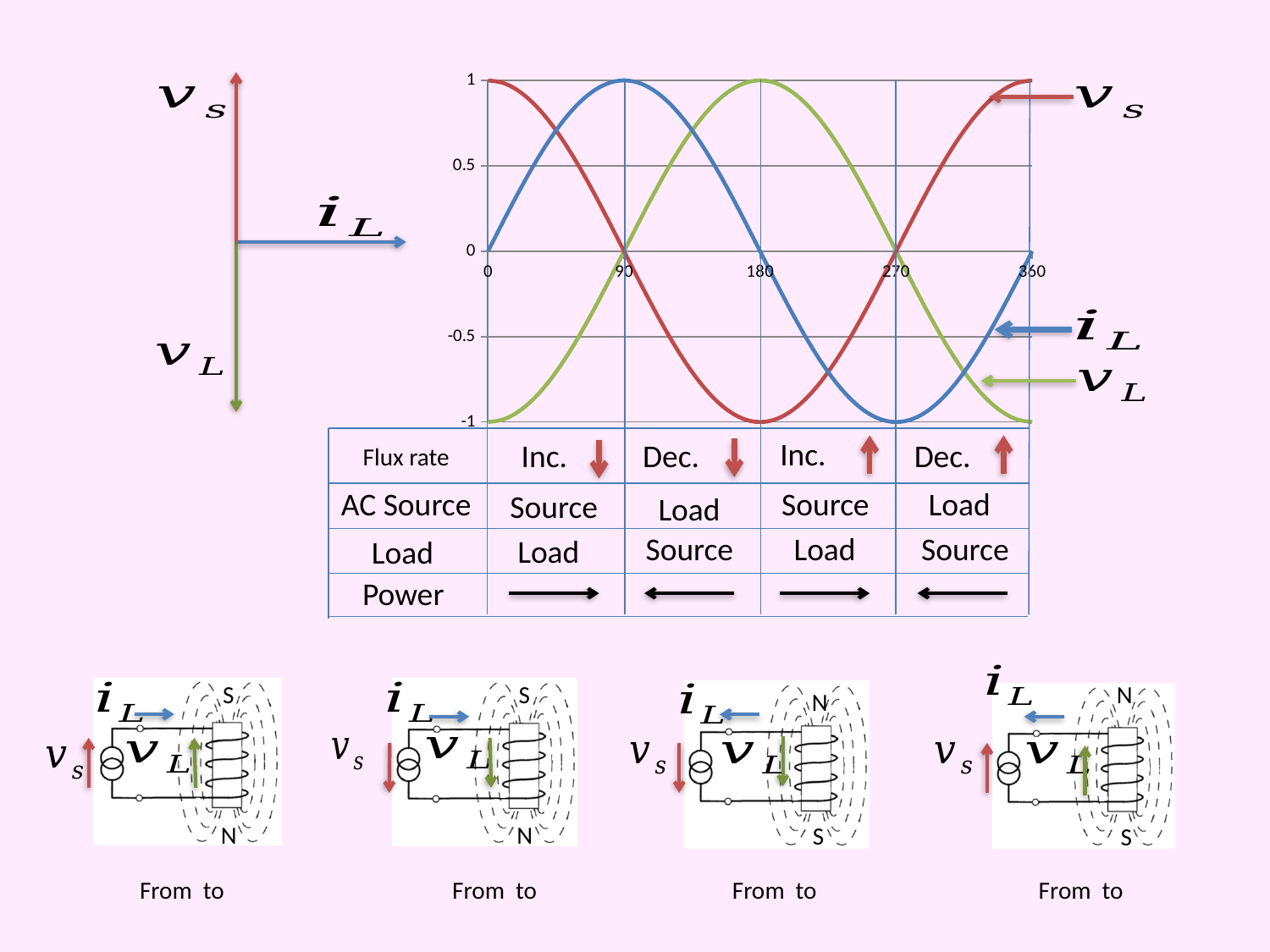
What is the value of the red v_s curve at 0 on the x axis? 1 What is the value of the blue i_L curve at 270 on the x axis? -1 How many curves are plotted on the chart? 3 How many labelled tick marks are on the x axis of the chart? 5 What kind of chart is shown on the slide? line chart At 90 on the x axis, which curve has the larger value, i_L or v_s? i_L What is the difference between the value of v_L and the value of v_s at 180 on the x axis? 2 What is the value of the green v_L curve at 180 on the x axis? 1 What is the value of the blue i_L curve at 90 on the x axis? 1 Does the red v_s curve rise or fall between 0 and 180 on the x axis? fall What is the value of the red v_s curve at 180 on the x axis? -1 What is the value of the green v_L curve at 0 on the x axis? -1